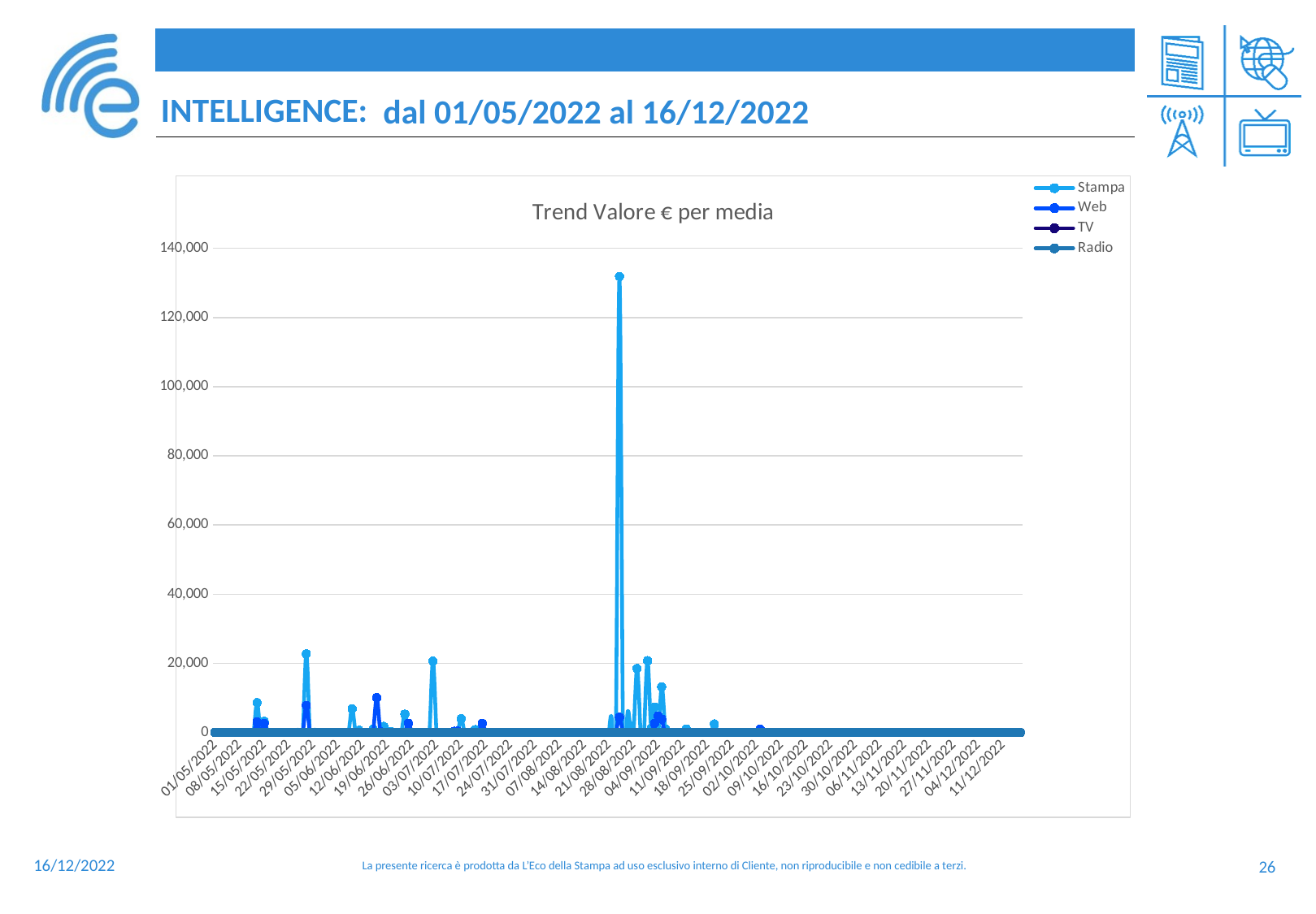
Which series are listed in the chart's legend? Stampa, Web, TV, Radio What kind of chart is shown on the slide? Line chart What is the title of the chart? Trend Valore € per media Is the highest peak of the Stampa series (around 28/08/2022) greater or less than 120,000? greater Which series reaches the highest value on the chart? Stampa Is the Stampa peak around 22/05/2022 greater or less than 40,000? less Is the Web peak around 19/06/2022 greater or less than 20,000? less How many series does the legend of the chart list? 4 Which is larger: the highest peak of the Stampa series or the highest peak of the Web series? Stampa